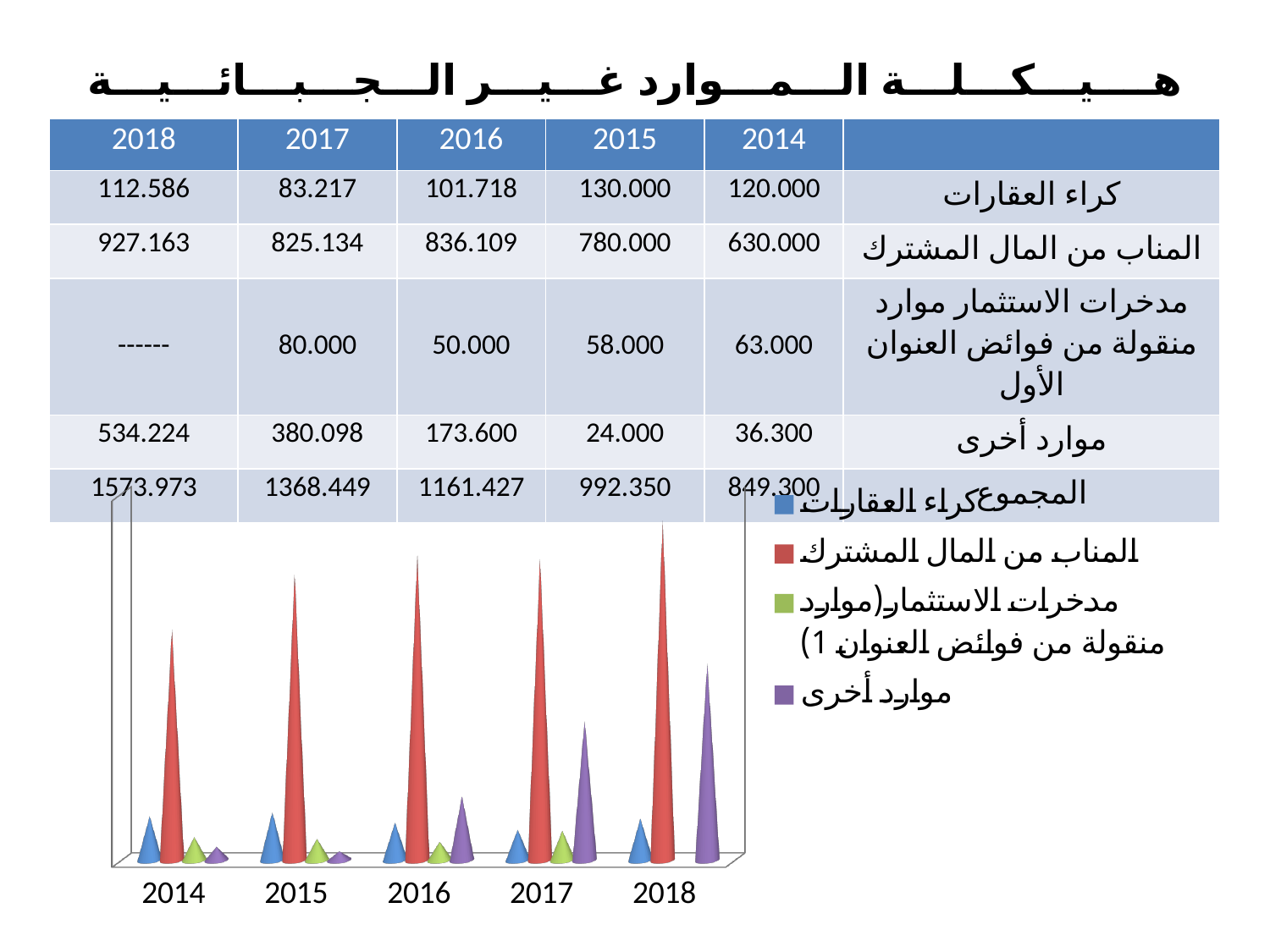
How many years are shown along the x axis of the chart? 5 What kind of chart is shown on the slide? bar chart What colour represents موارد أخرى in the chart? purple Which series has the shortest bar in 2015? موارد أخرى Which series has the tallest bar in every year of the chart? المناب من المال المشترك In 2014, which is larger: the bar for كراء العقارات or the bar for مدخرات الاستثمار? كراء العقارات How many series does the chart legend list? 4 Do the bars for موارد أخرى rise or fall from 2015 to 2018? rise In 2018, which is larger: the bar for موارد أخرى or the bar for كراء العقارات? موارد أخرى In which year is the bar for موارد أخرى the tallest? 2018 In which year is the bar for المناب من المال المشترك the tallest? 2018 In which year is the bar for موارد أخرى the shortest? 2015